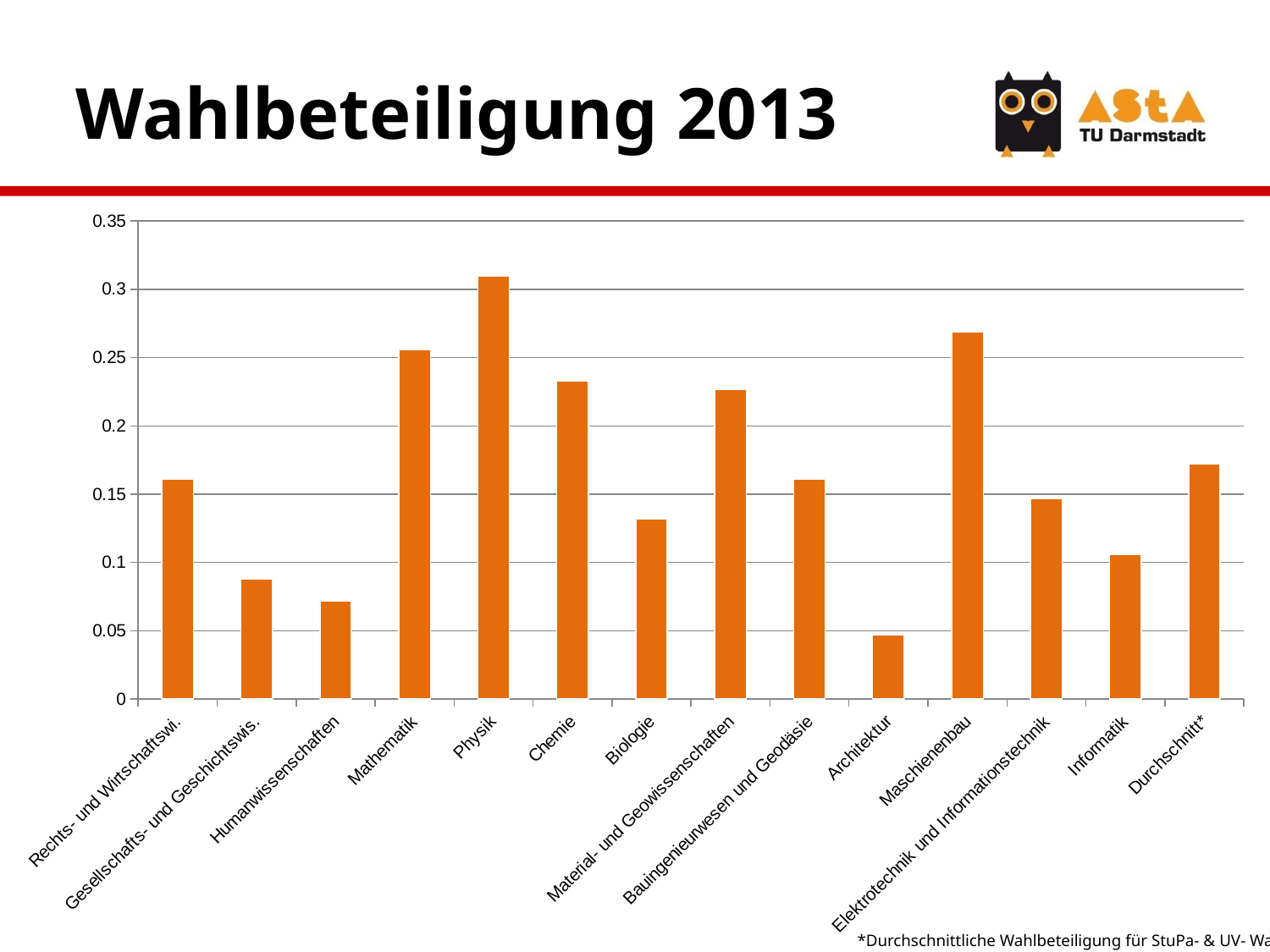
Is the value for Chemie greater or less than 0.2? greater Which has the larger value, Biologie or Informatik? Biologie Is the value for Humanwissenschaften greater or less than 0.1? less What kind of chart is shown on the slide? bar chart Is the value for Physik greater or less than 0.25? greater Which has the larger value, Physik or Maschinenbau? Physik What is the title of the slide containing the chart? Wahlbeteiligung 2013 Which category has the highest value in the chart? Physik Which category has the lowest value in the chart? Architektur How many categories are shown on the x axis of the chart? 14